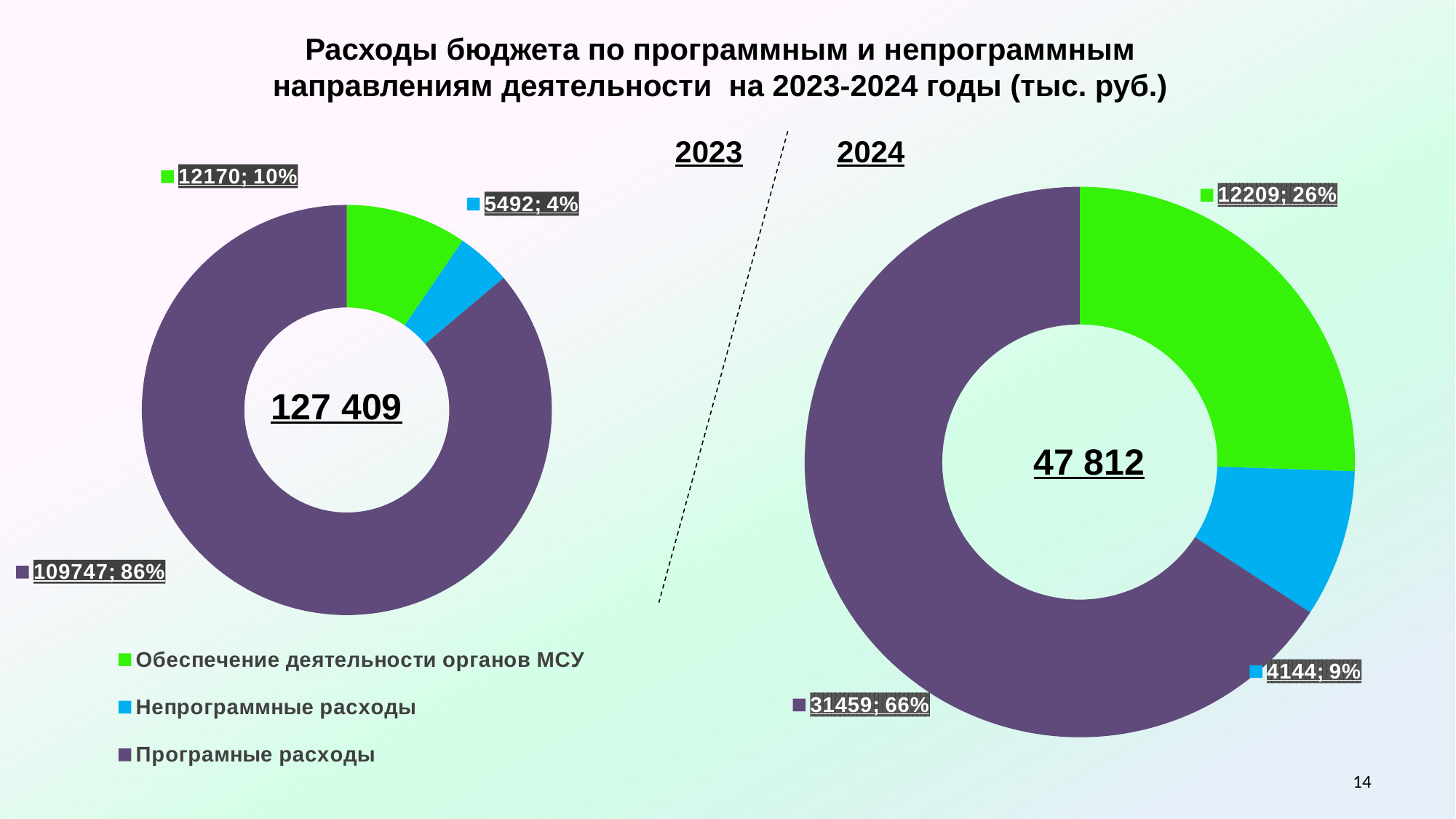
In the 2024 chart, what is the difference between Програмные расходы and Обеспечение деятельности органов МСУ? 19250 In the 2023 chart, which is larger: Обеспечение деятельности органов МСУ or Непрограммные расходы? Обеспечение деятельности органов МСУ In the 2023 chart, which category has the largest value? Програмные расходы What kind of chart is used for the 2023 data? Donut (pie) chart In the 2024 chart, what is the value for Непрограммные расходы? 4144 In the 2024 chart, which category has the smallest value? Непрограммные расходы In the 2023 chart, what is the value for Програмные расходы? 109747 How many categories does the legend list? 3 Which colour represents Непрограммные расходы in the legend? Blue In the 2024 chart, what percentage share does Обеспечение деятельности органов МСУ have? 26% In the 2023 chart, what percentage share does Непрограммные расходы have? 4% What total is shown in the centre of the 2024 chart? 47 812